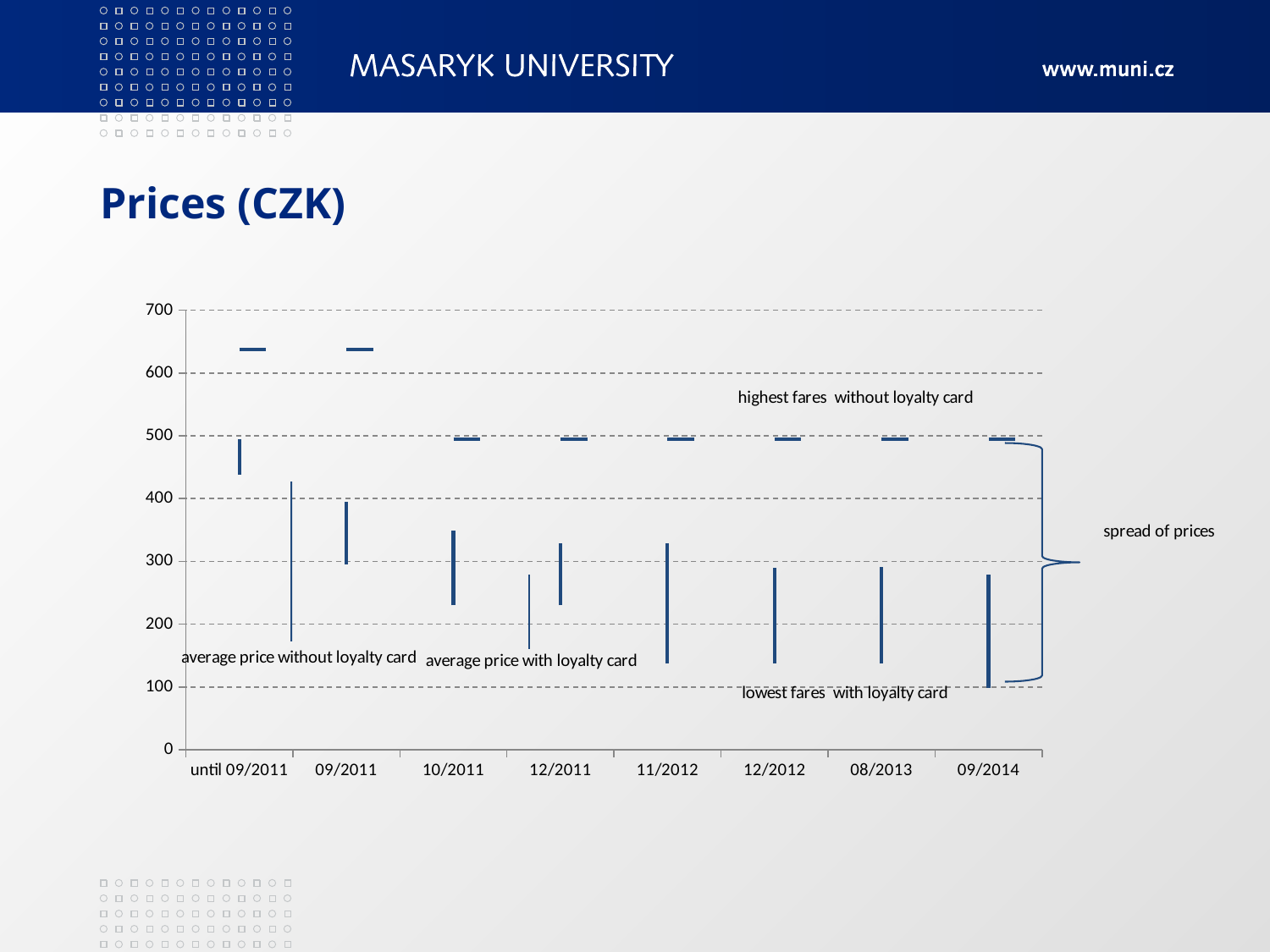
Which period has the lowest fare with loyalty card? 09/2014 What does the brace on the right side of the chart label? spread of prices Is the highest fare without loyalty card for 12/2012 greater or less than 600? less Is the lowest fare with loyalty card for 12/2011 greater or less than 200? greater Is the lowest fare with loyalty card for 11/2012 greater or less than 200? less What is the maximum value shown on the y axis of the chart? 700 What is the title of the chart? Prices (CZK) Do the highest fares without loyalty card rise or fall from 09/2011 to 10/2011? fall How many time-period categories are shown on the x axis of the chart? 8 Which is larger, the highest fare without loyalty card for 09/2011 or for 10/2011? 09/2011